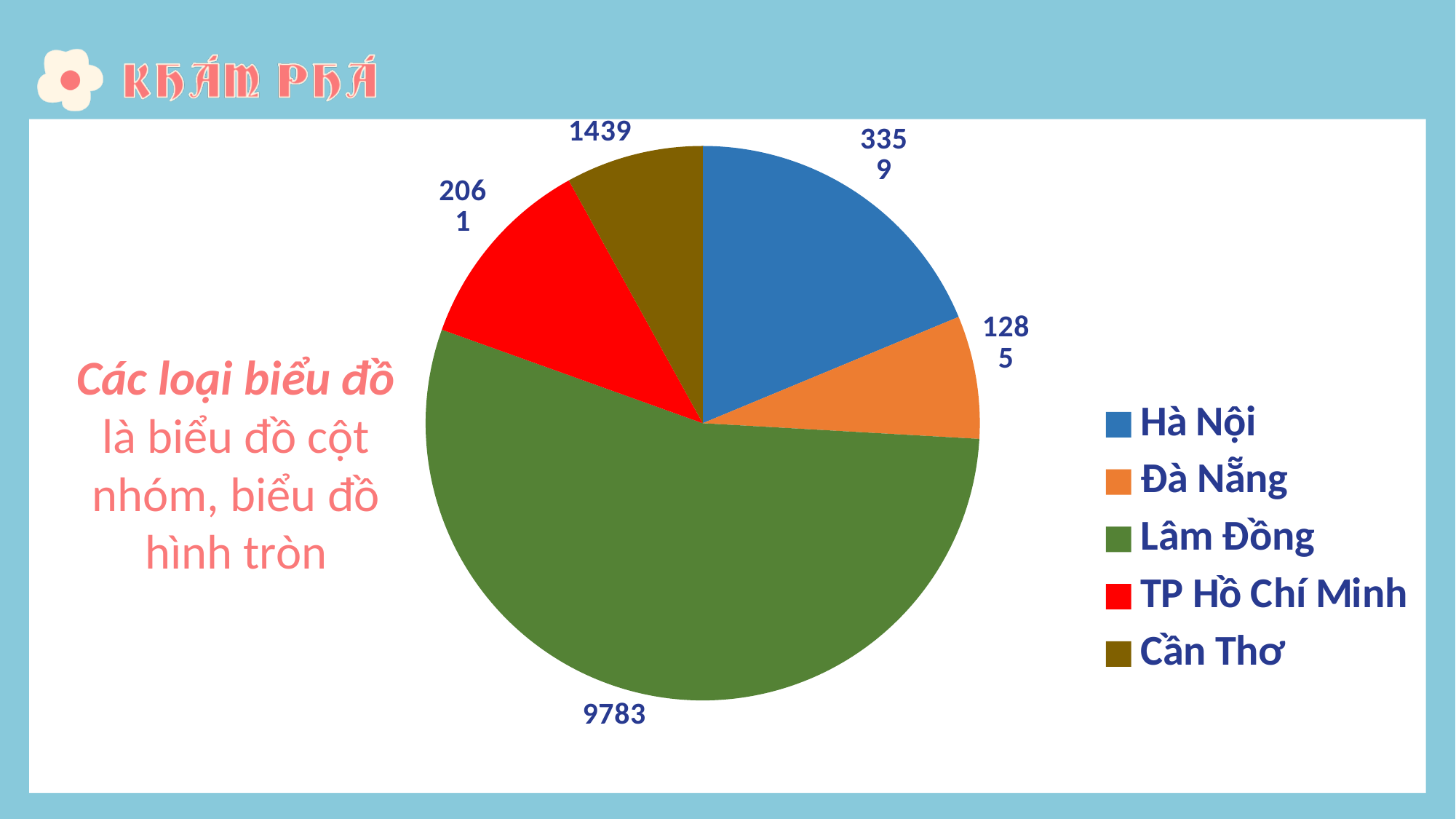
Which category has the largest slice of the pie? Lâm Đồng What is the difference between the values for Lâm Đồng and Hà Nội? 6424 What is the value for Hà Nội? 3359 What is the value for TP Hồ Chí Minh? 2061 What is the value for Cần Thơ? 1439 Which category has the smallest slice of the pie? Đà Nẵng Which is larger, the value for TP Hồ Chí Minh or the value for Cần Thơ? TP Hồ Chí Minh What kind of chart is shown on the slide? pie chart What is the value for Lâm Đồng? 9783 What is the difference between the values for Hà Nội and Đà Nẵng? 2074 How many categories does the pie chart have? 5 What colour is the slice for TP Hồ Chí Minh? red